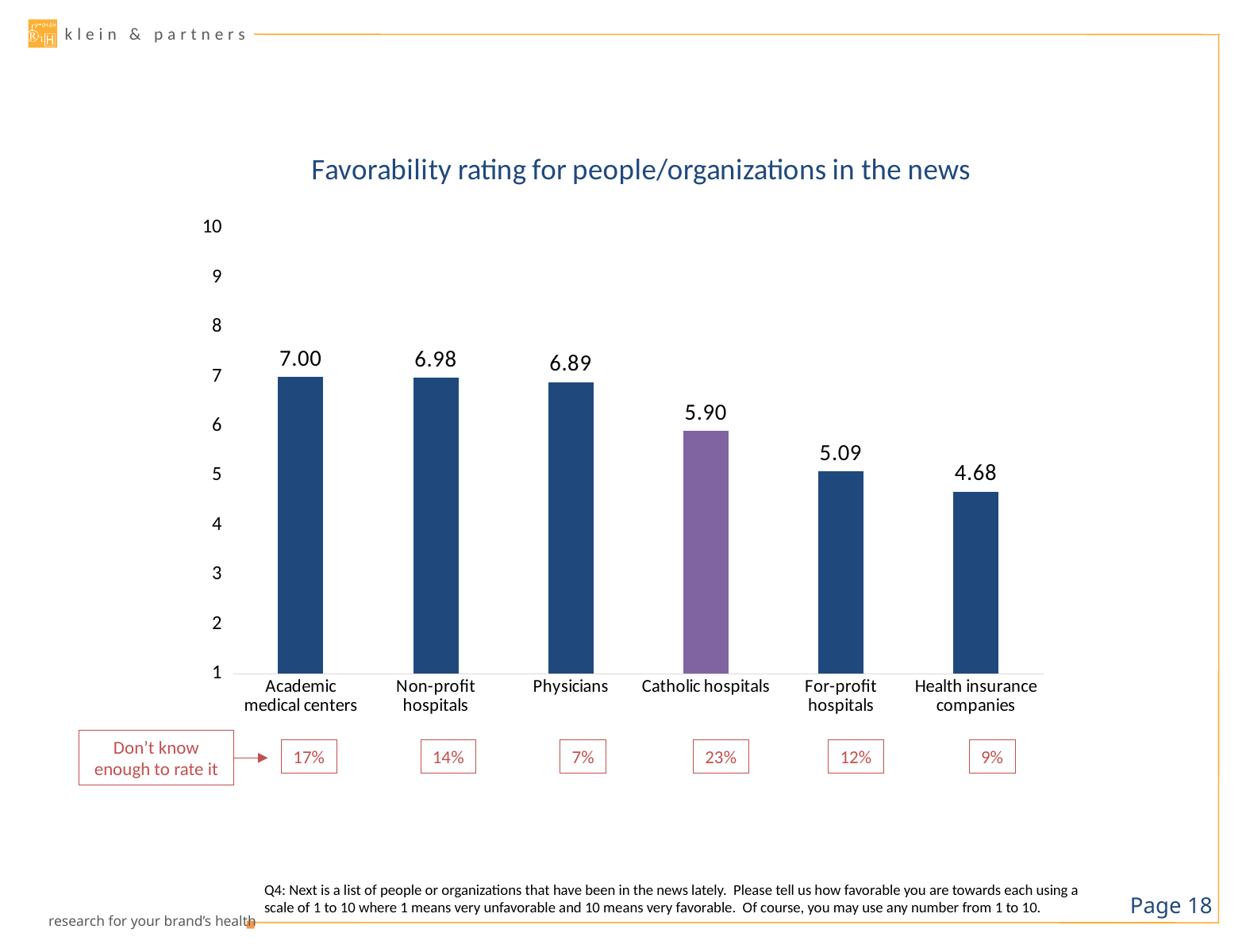
Is the favorability rating for For-profit hospitals greater or less than 6? less How many categories are shown in the chart? 6 What is the favorability rating for Catholic hospitals? 5.90 What is the favorability rating for Health insurance companies? 4.68 What is the title of the chart? Favorability rating for people/organizations in the news Which category has the lowest favorability rating? Health insurance companies Which has a higher favorability rating, Physicians or Catholic hospitals? Physicians What kind of chart is shown on the slide? Bar chart What is the difference between the favorability ratings for Catholic hospitals and For-profit hospitals? 0.81 Do the favorability ratings rise or fall from left to right across the categories? Fall What is the favorability rating for Physicians? 6.89 Which category has the highest favorability rating? Academic medical centers